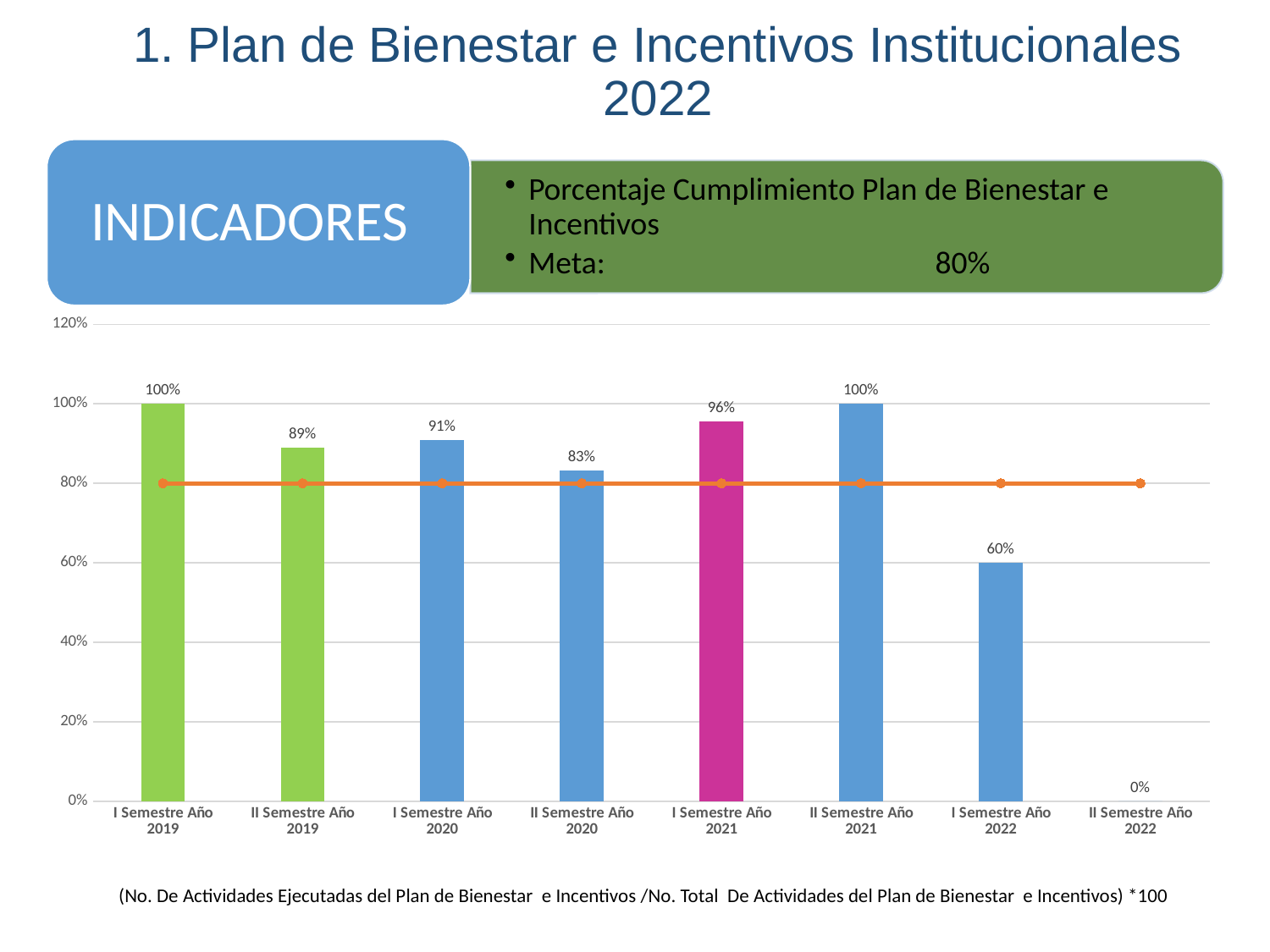
What kind of chart is shown on the slide? combination bar and line chart How many categories are shown on the x axis? 8 What is the difference between the values for II Semestre Año 2021 and I Semestre Año 2022? 40% Which is larger, the value for II Semestre Año 2019 or the value for I Semestre Año 2020? I Semestre Año 2020 Which category has the lowest value? II Semestre Año 2022 At what value is the horizontal orange line drawn across the chart? 80% What is the value for I Semestre Año 2022? 60% What is the value for I Semestre Año 2020? 91% What is the value for II Semestre Año 2020? 83% What is the difference between the values for I Semestre Año 2021 and II Semestre Año 2020? 13% What is the value for II Semestre Año 2022? 0% Is the value for I Semestre Año 2022 greater or less than 80%? less